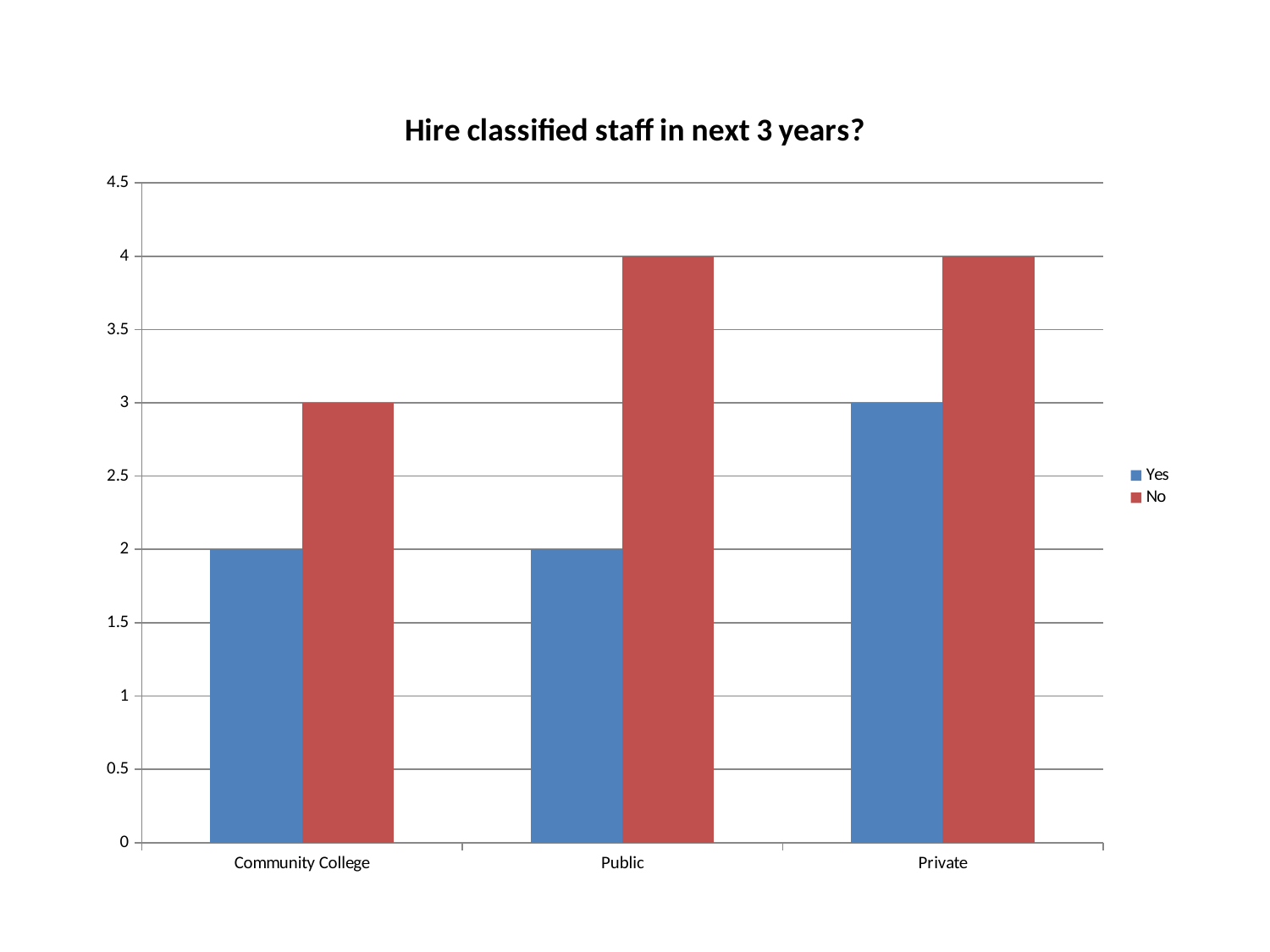
How many series does the legend list? 2 What is the value of the No bar for Public? 4 For Community College, which is larger, the Yes bar or the No bar? No Which category has the highest Yes value? Private What is the title of the chart? Hire classified staff in next 3 years? What is the value of the Yes bar for Community College? 2 What kind of chart is shown on the slide? bar chart What is the difference between the No and Yes values for Public? 2 What is the value of the Yes bar for Private? 3 How many categories are shown on the x axis? 3 Is the No value for Private greater or less than 3.5? greater Which category has the lowest No value? Community College